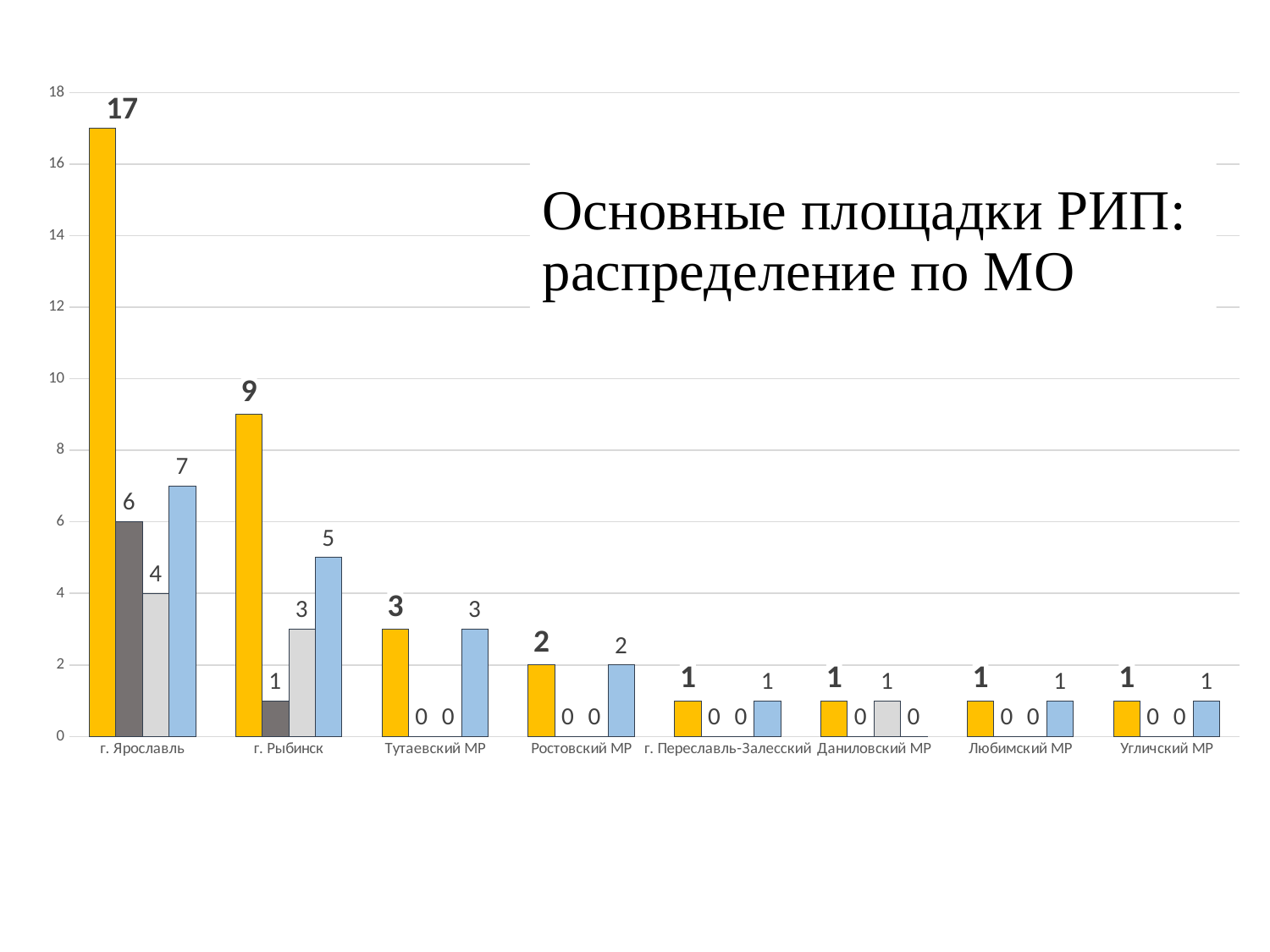
How many categories are shown on the x axis? 8 Which is larger: the blue bar for г. Ярославль or the blue bar for г. Рыбинск? г. Ярославль What is the value of the yellow bar for Тутаевский МР? 3 Do the yellow bars rise or fall from left to right along the x axis? fall What is the title shown on the slide? Основные площадки РИП: распределение по МО What is the value of the yellow bar for г. Ярославль? 17 What is the difference between the yellow bars for г. Ярославль and г. Рыбинск? 8 What is the value of the dark grey bar for г. Ярославль? 6 What type of chart is shown on the slide? bar chart What is the value of the light grey bar for Даниловский МР? 1 Which category has the highest yellow bar? г. Ярославль What is the value of the blue bar for г. Рыбинск? 5